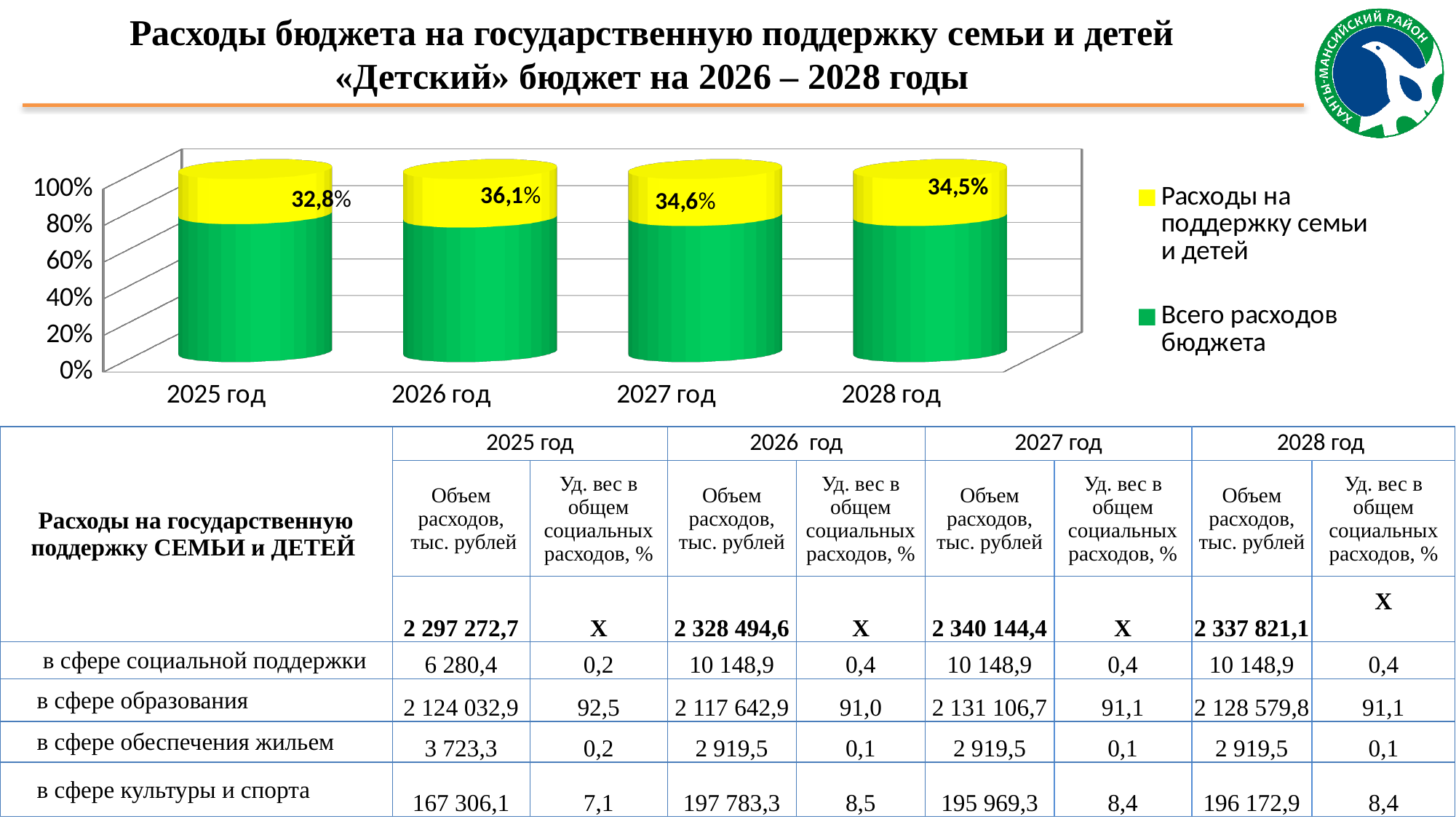
What is the difference between the labelled shares for 2026 год and 2025 год? 3,3 percentage points In which year is the labelled share for Расходы на поддержку семьи и детей the highest? 2026 год Which year has a larger labelled share: 2027 год or 2028 год? 2027 год What value is labelled on the yellow segment (Расходы на поддержку семьи и детей) for 2025 год? 32,8% What value is labelled on the yellow segment for 2026 год? 36,1% What value is labelled on the yellow segment for 2027 год? 34,6% Which legend entry is shown in green? Всего расходов бюджета How many years (categories) are shown on the x axis of the chart? 4 How many series does the chart legend list? 2 In which year is the labelled share for Расходы на поддержку семьи и детей the lowest? 2025 год What kind of chart is shown on the slide? Stacked bar chart What value is labelled on the yellow segment for 2028 год? 34,5%